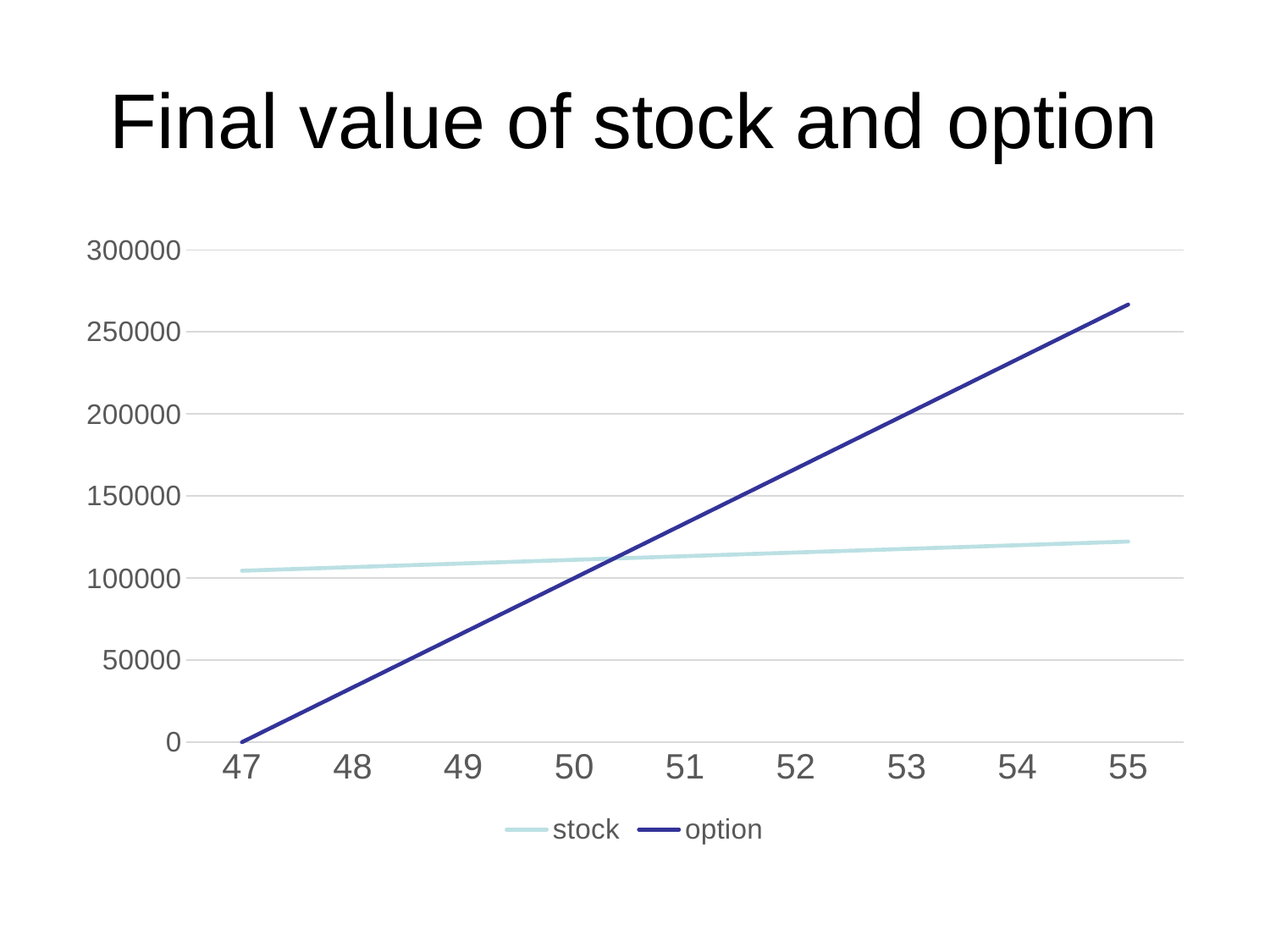
What is the title of the chart? Final value of stock and option Is the value of the option series at 49 greater or less than 100000? less What is the value of the option series at 47? 0 At 55, which series has the larger value, stock or option? option Does the option series rise or fall as the x-axis value increases from 47 to 55? rise How many x-axis points are plotted for each series? 9 Is the value of the option series at 54 greater or less than 200000? greater How many series does the legend list? 2 At 48, which series has the larger value, stock or option? stock What kind of chart is shown on the slide? line chart Is the value of the option series at 55 greater or less than 250000? greater